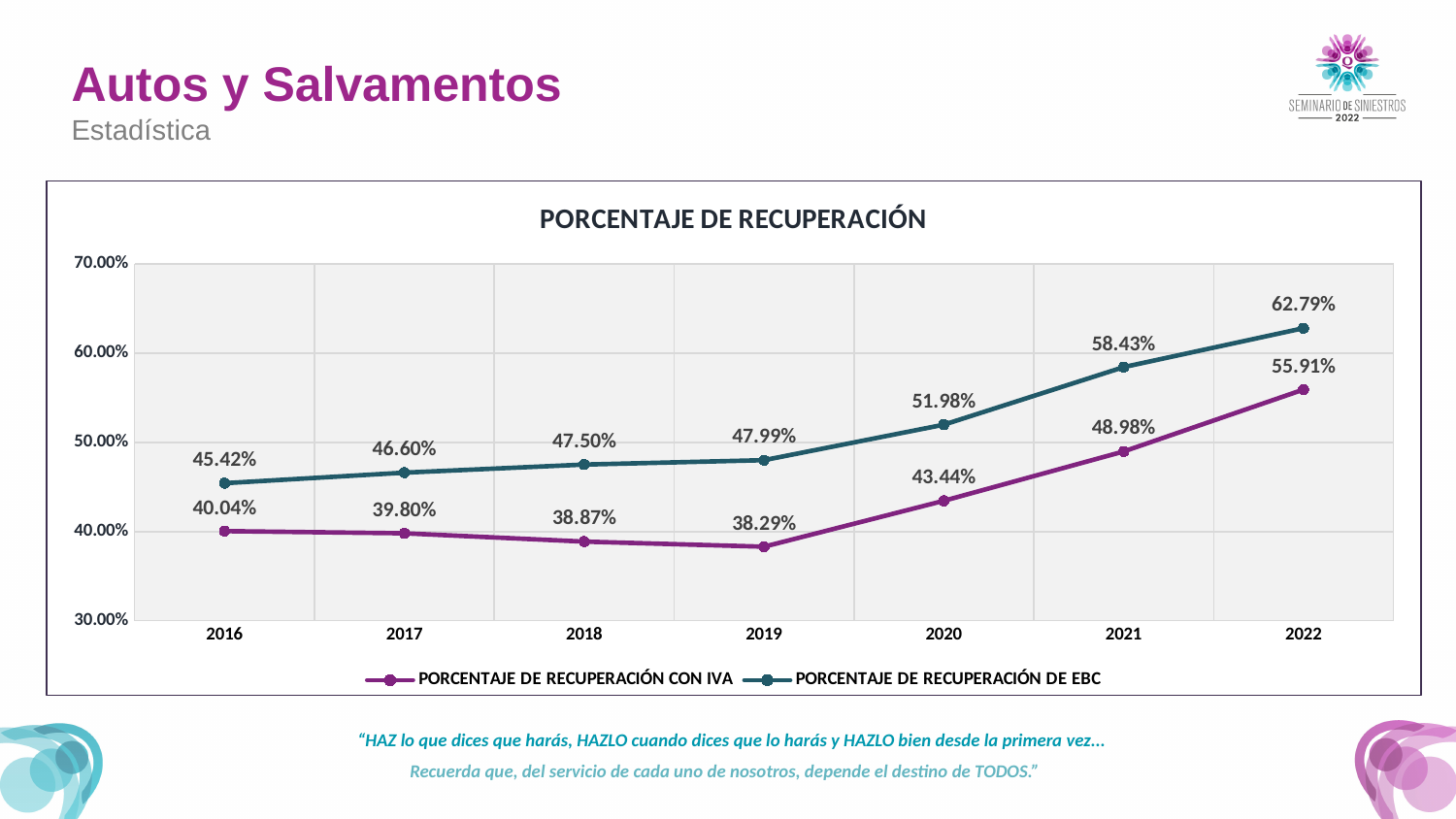
What is the difference between PORCENTAJE DE RECUPERACIÓN DE EBC and PORCENTAJE DE RECUPERACIÓN CON IVA in 2022? 6.88% What is the value of PORCENTAJE DE RECUPERACIÓN DE EBC in 2021? 58.43% Is the value for PORCENTAJE DE RECUPERACIÓN CON IVA in 2021 greater or less than 50.00%? less Does PORCENTAJE DE RECUPERACIÓN DE EBC rise or fall from 2016 to 2022? Rise In which year is PORCENTAJE DE RECUPERACIÓN DE EBC highest? 2022 What is the value of PORCENTAJE DE RECUPERACIÓN CON IVA in 2019? 38.29% Which is larger in 2020: PORCENTAJE DE RECUPERACIÓN CON IVA or PORCENTAJE DE RECUPERACIÓN DE EBC? PORCENTAJE DE RECUPERACIÓN DE EBC What type of chart is shown on the slide? Line chart In which year is PORCENTAJE DE RECUPERACIÓN CON IVA lowest? 2019 How many years are shown on the x axis? 7 What is the title of the chart? PORCENTAJE DE RECUPERACIÓN How many series does the legend list? 2